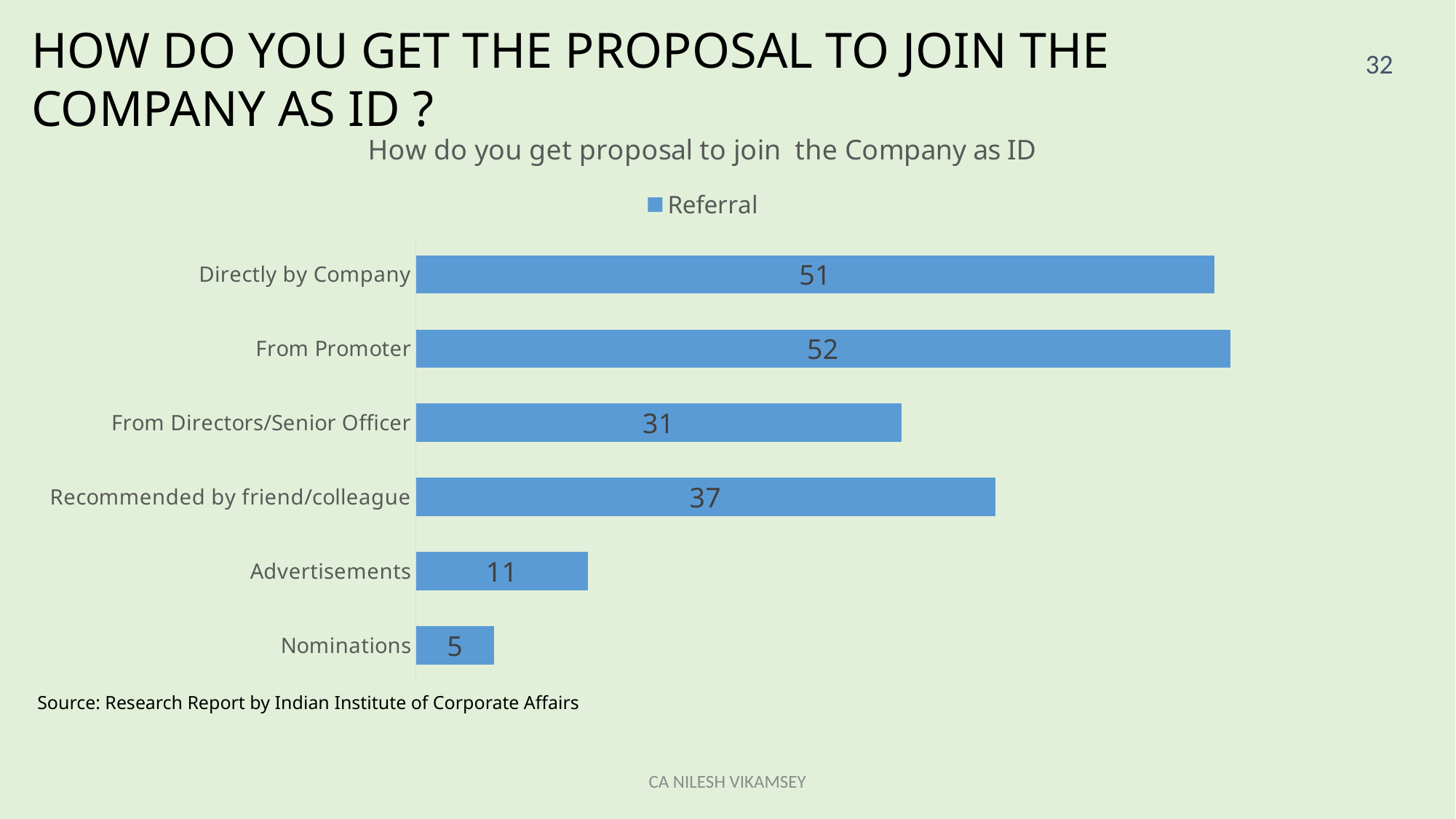
What series name does the legend show? Referral What kind of chart is shown on the slide? Bar chart Which category has the lowest value? Nominations What is the difference between the values for From Promoter and Directly by Company? 1 What is the value for Advertisements? 11 What is the value for From Directors/Senior Officer? 31 What is the difference between the values for Recommended by friend/colleague and From Directors/Senior Officer? 6 Which is larger, the value for Recommended by friend/colleague or the value for From Directors/Senior Officer? Recommended by friend/colleague What is the value for Recommended by friend/colleague? 37 How many categories are shown in the chart? 6 What is the value for From Promoter? 52 What is the value for Directly by Company? 51